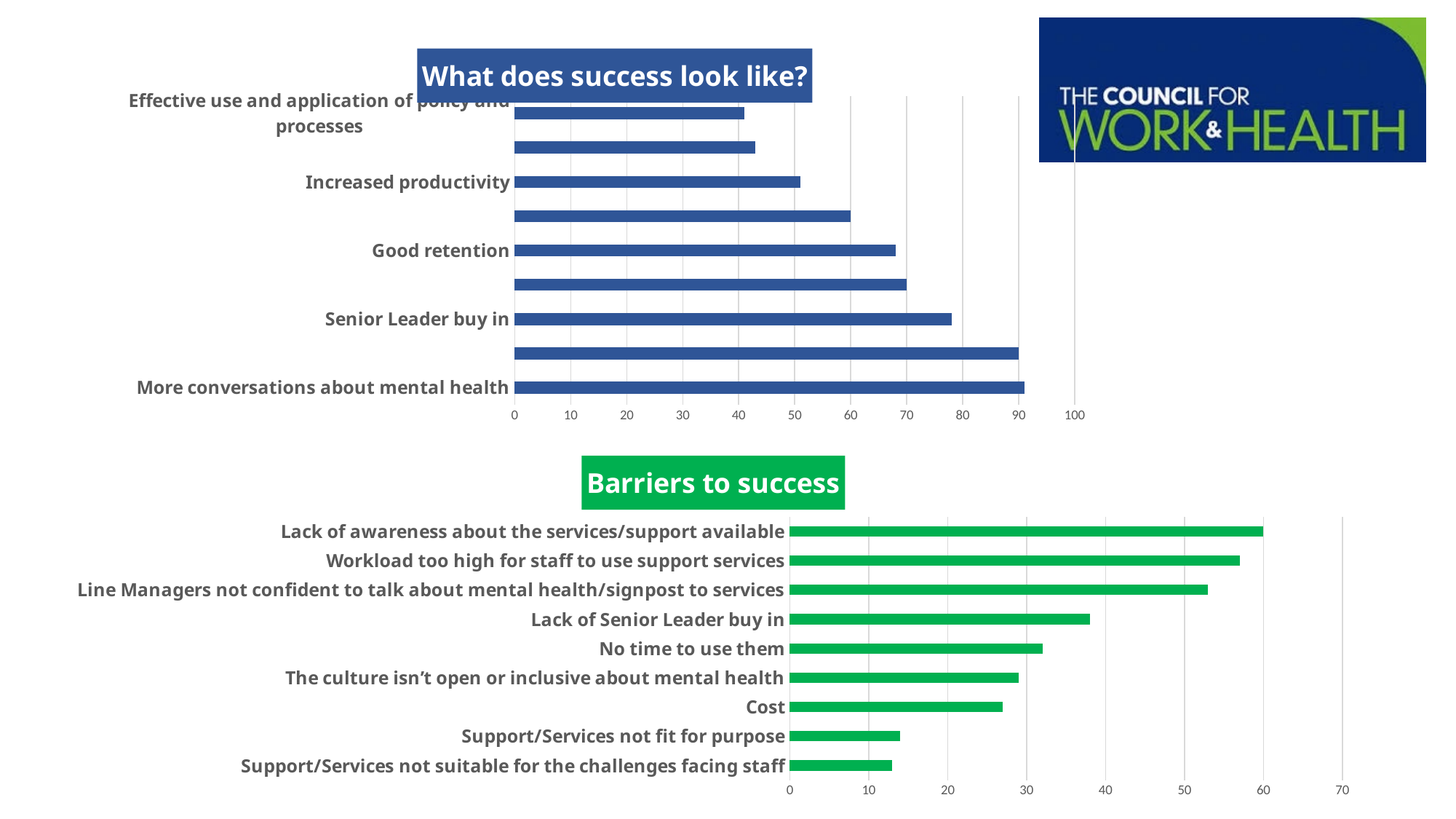
In the 'Barriers to success' chart, is the value for 'Lack of Senior Leader buy in' greater or less than 40? less In the 'What does success look like?' chart, which is larger: 'Senior Leader buy in' or 'Good retention'? Senior Leader buy in In the 'Barriers to success' chart, how many barriers are listed? 9 What colour are the bars in the 'Barriers to success' chart? green In the 'Barriers to success' chart, which barrier has the highest value? Lack of awareness about the services/support available In the 'What does success look like?' chart, is the value for 'Effective use and application of policy and processes' greater or less than 50? less What kind of chart is the 'Barriers to success' chart? bar chart In the 'Barriers to success' chart, which is larger: 'No time to use them' or 'Cost'? No time to use them In the 'Barriers to success' chart, is the value for 'Workload too high for staff to use support services' greater or less than 50? greater